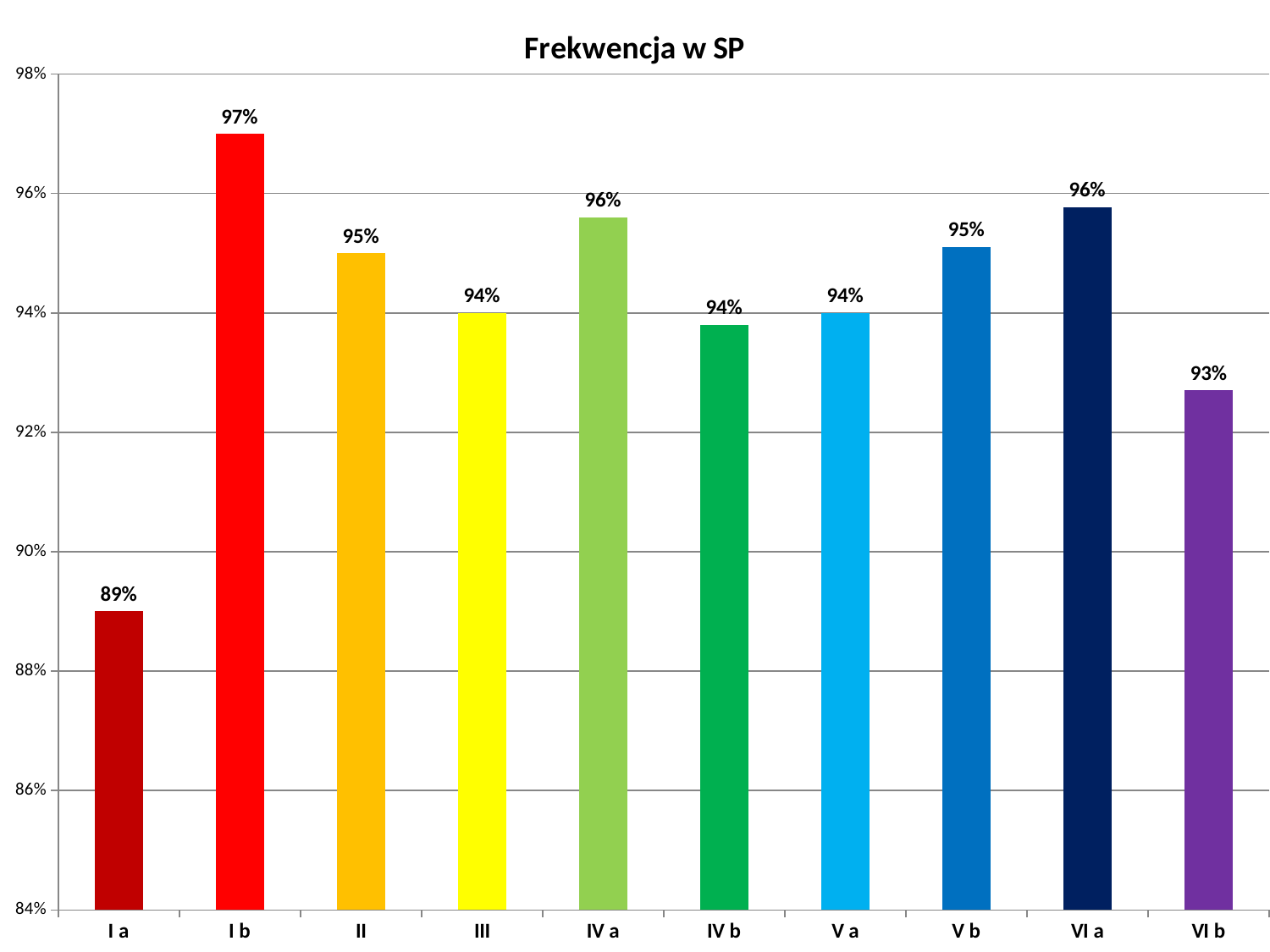
What is the difference between the values for I b and I a? 8 percentage points What is the value for VI b? 93% Which is larger, the value for I b or the value for VI b? I b Which category has the lowest value? I a Is the value for VI b greater or less than 92%? greater What is the value for I b? 97% Which category has the highest value? I b Is the value for I a greater or less than 90%? less How many categories are shown on the x axis? 10 What is the title of the chart? Frekwencja w SP What is the value for I a? 89% What kind of chart is shown on the slide? bar chart